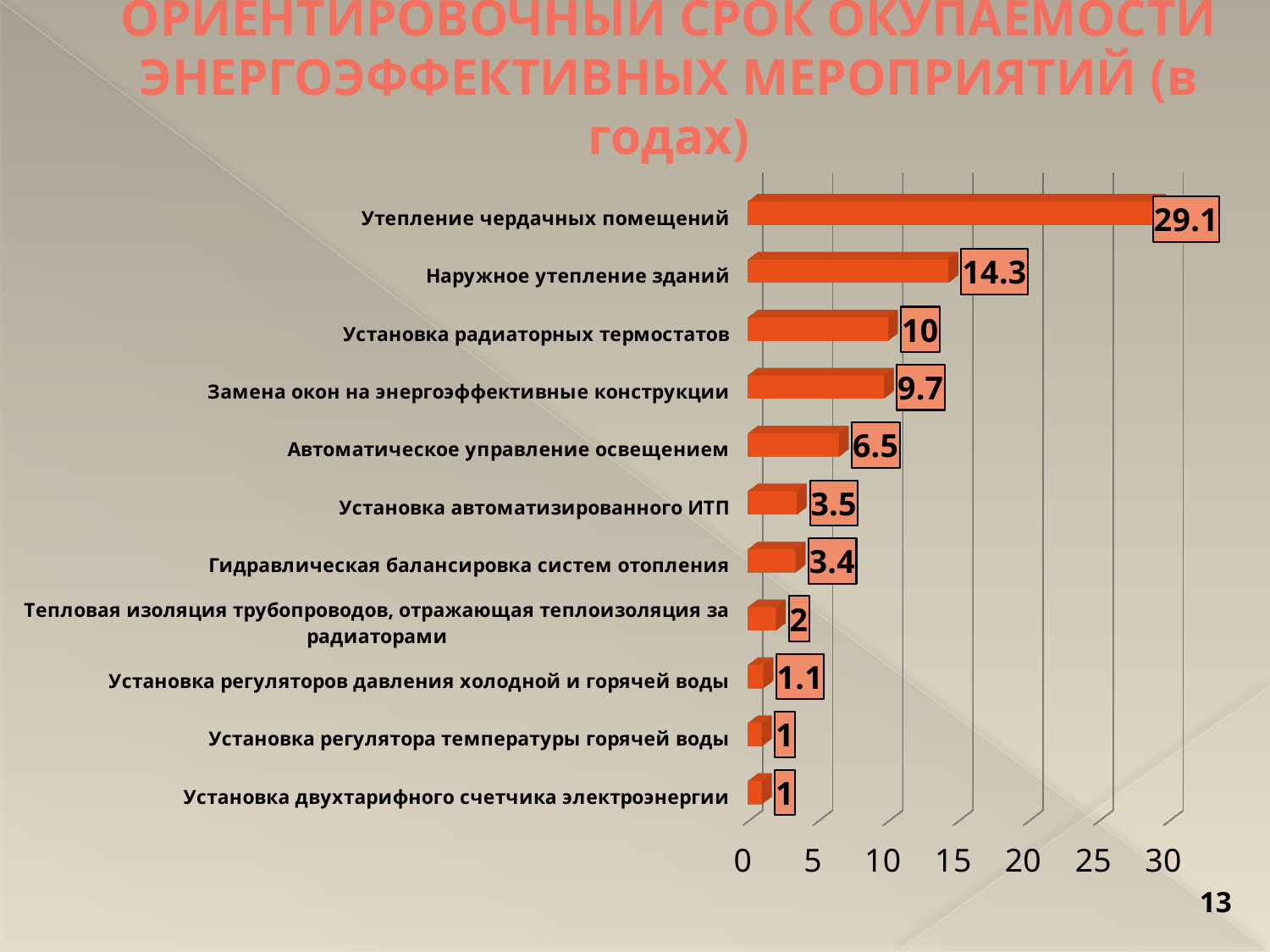
How many measures (categories) are shown in the chart? 11 What is the difference between the values for Установка радиаторных термостатов and Замена окон на энергоэффективные конструкции? 0.3 Is the value for Наружное утепление зданий greater or less than 10? greater Which is larger: the value for Установка автоматизированного ИТП or the value for Тепловая изоляция трубопроводов, отражающая теплоизоляция за радиаторами? Установка автоматизированного ИТП What is the highest value shown on the horizontal axis? 30 What is the difference between the values for Утепление чердачных помещений and Наружное утепление зданий? 14.8 What is the payback period for Утепление чердачных помещений? 29.1 What is the value shown for Наружное утепление зданий? 14.3 What is the value shown for Установка регуляторов давления холодной и горячей воды? 1.1 Which measure has the longest payback period? Утепление чердачных помещений What kind of chart is shown on the slide? bar chart What is the value shown for Автоматическое управление освещением? 6.5